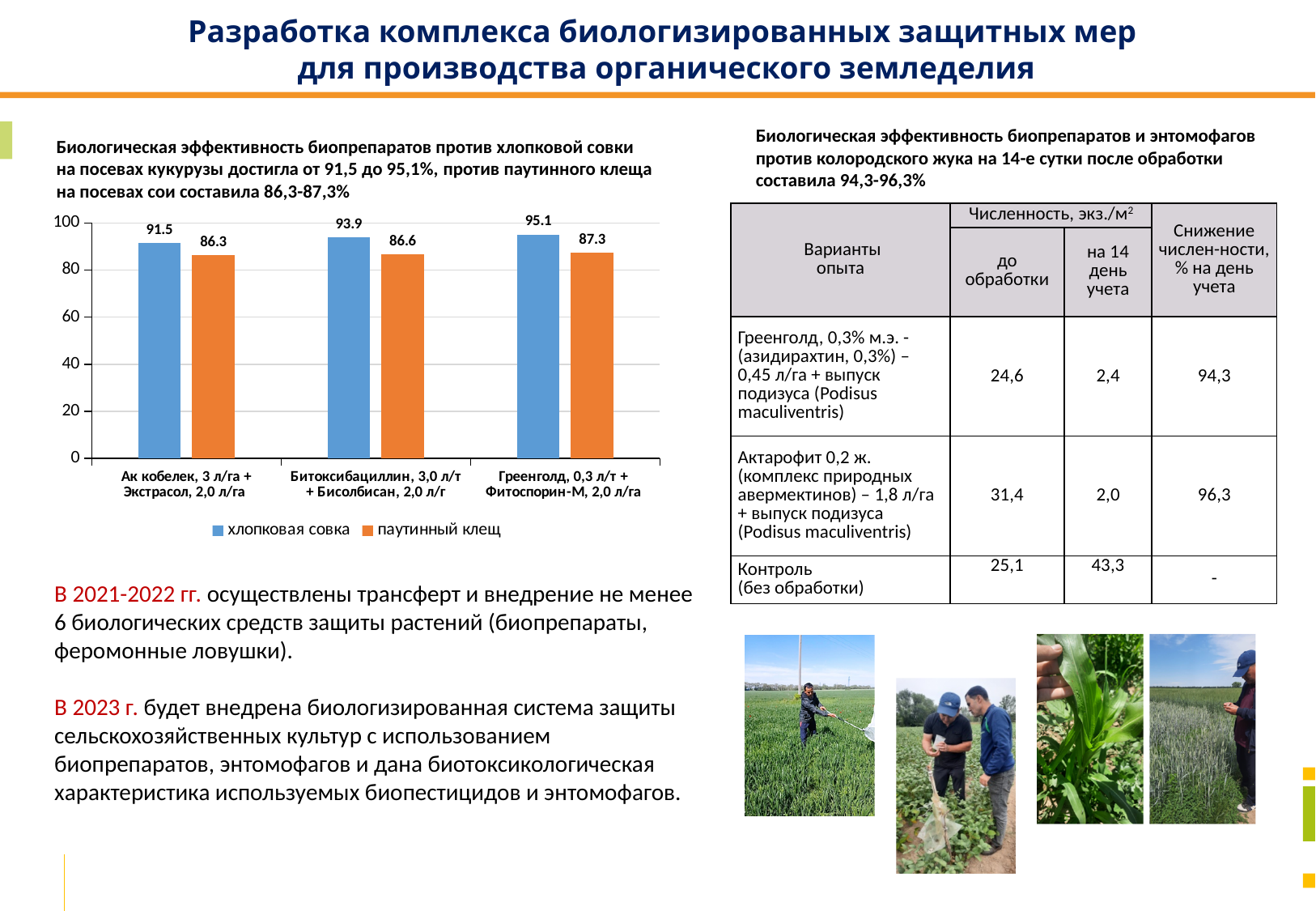
What type of chart is shown on the slide? bar chart What is the value for хлопковая совка for Греенголд, 0,3 л/т + Фитоспорин-М, 2,0 л/га? 95.1 Do the values for хлопковая совка rise or fall from left to right along the x axis? rise Which category has the lowest value for паутинный клещ? Ак кобелек, 3 л/га + Экстрасол, 2,0 л/га What is the value for хлопковая совка for Ак кобелек, 3 л/га + Экстрасол, 2,0 л/га? 91.5 For Битоксибациллин, 3,0 л/т + Бисолбисан, 2,0 л/г, which series has the larger value: хлопковая совка or паутинный клещ? хлопковая совка What is the difference between the хлопковая совка and паутинный клещ values for Греенголд, 0,3 л/т + Фитоспорин-М, 2,0 л/га? 7.8 What is the value for паутинный клещ for Битоксибациллин, 3,0 л/т + Бисолбисан, 2,0 л/г? 86.6 How many categories are shown on the x axis of the chart? 3 Which series is shown in orange in the chart? паутинный клещ Which category has the highest value for хлопковая совка? Греенголд, 0,3 л/т + Фитоспорин-М, 2,0 л/га How many series does the chart legend list? 2